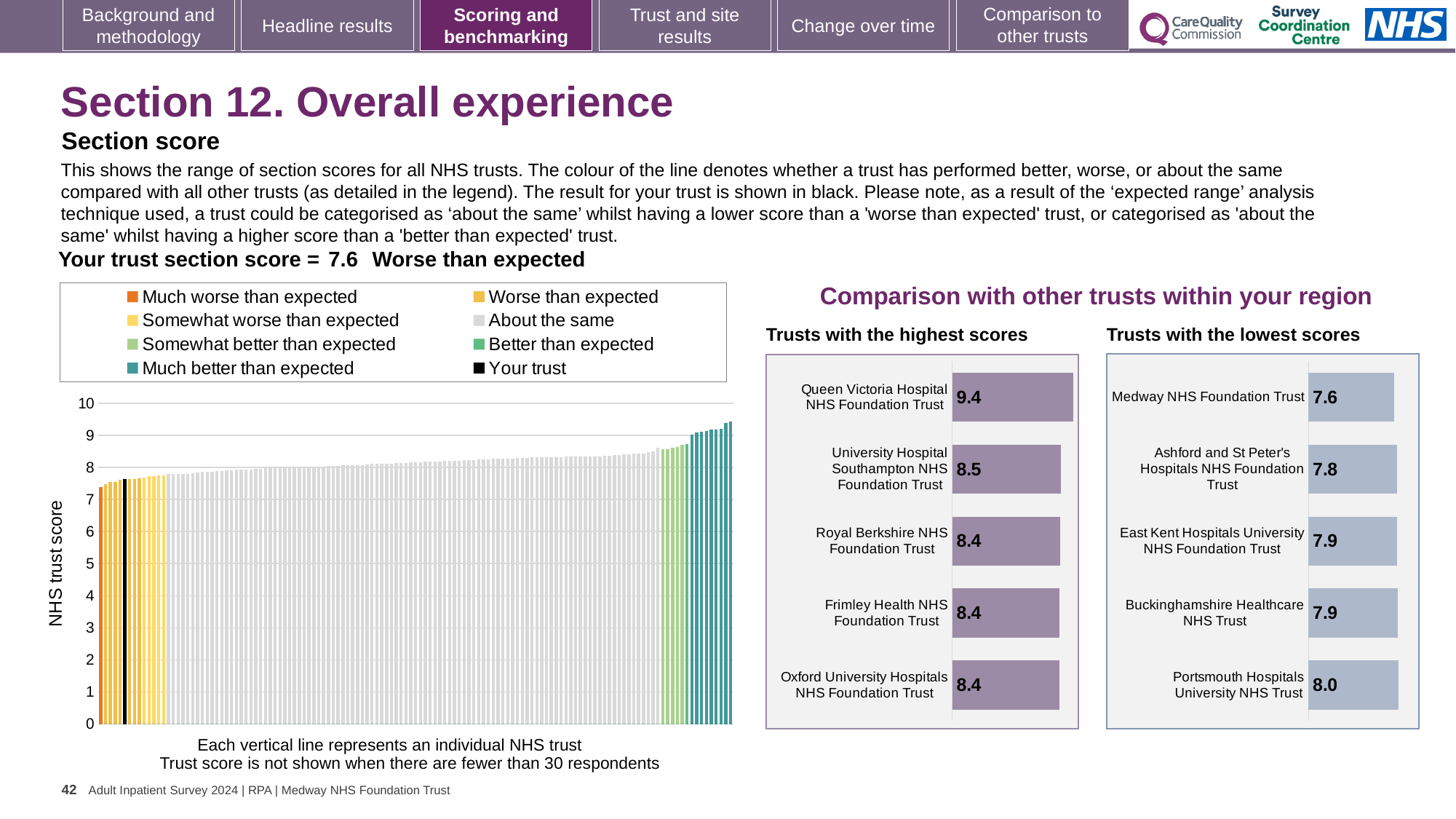
In the 'Trusts with the lowest scores' chart, what is the score for Portsmouth Hospitals University NHS Trust? 8.0 In the 'Trusts with the highest scores' chart, what is the score for University Hospital Southampton NHS Foundation Trust? 8.5 In the 'Trusts with the lowest scores' chart, what is the difference between the scores of Portsmouth Hospitals University NHS Trust and Medway NHS Foundation Trust? 0.4 In the 'Trusts with the highest scores' chart, which trust has the highest score? Queen Victoria Hospital NHS Foundation Trust In the 'Trusts with the highest scores' chart, what is the difference between the scores of Queen Victoria Hospital NHS Foundation Trust and University Hospital Southampton NHS Foundation Trust? 0.9 In the 'Trusts with the lowest scores' chart, which trust has the lowest score? Medway NHS Foundation Trust What kind of chart is the NHS trust score chart on the left of the slide? Bar chart In the NHS trust score chart on the left, is the value of the tallest bar greater or less than 9? greater In the 'Trusts with the lowest scores' chart, what is the score for Medway NHS Foundation Trust? 7.6 How many trusts are shown in the 'Trusts with the lowest scores' chart? 5 How many entries does the legend of the NHS trust score chart on the left list? 8 In the 'Trusts with the highest scores' chart, what is the score for Queen Victoria Hospital NHS Foundation Trust? 9.4